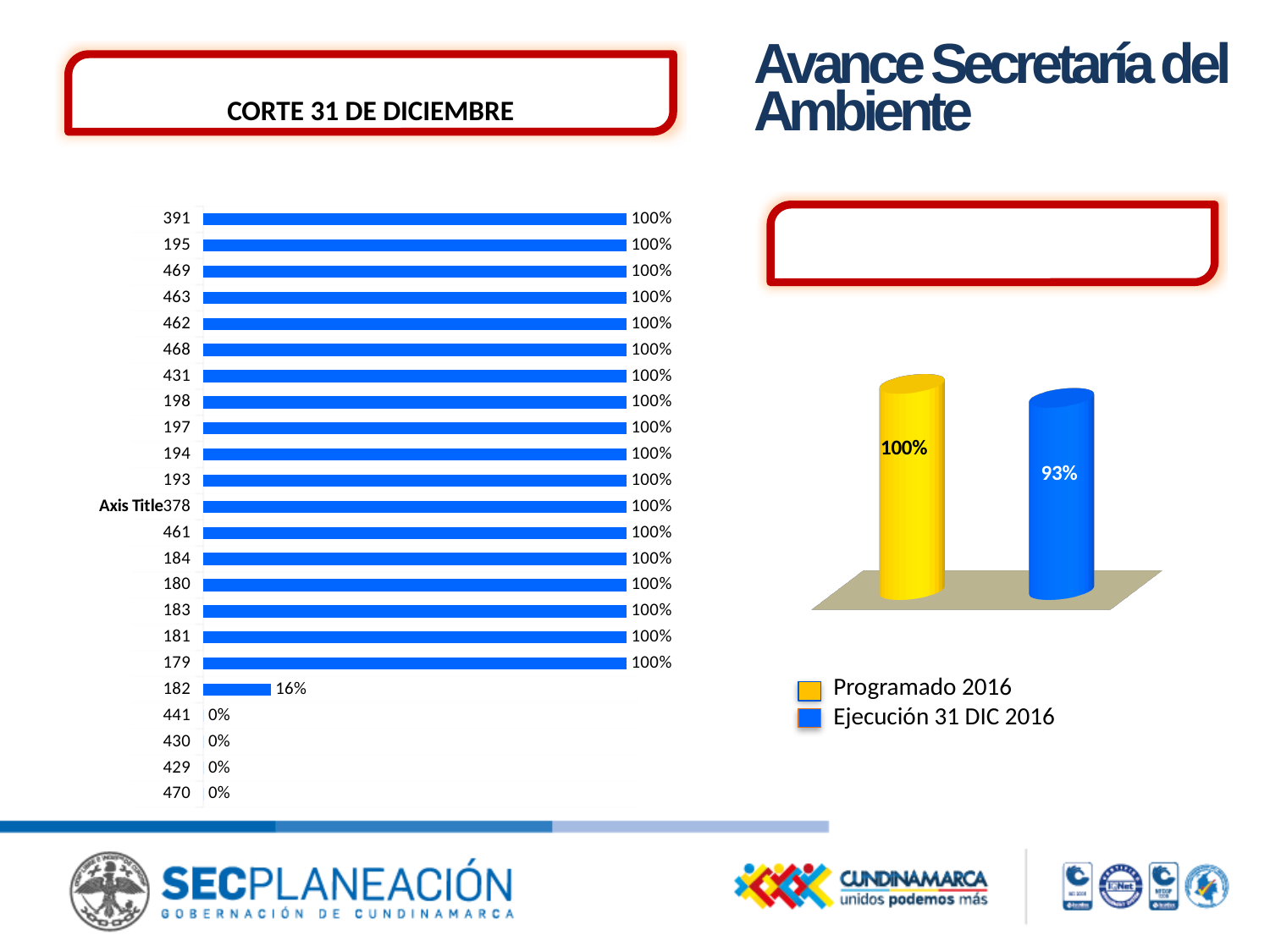
In the left bar chart, what is the difference between the value for 179 and the value for 182? 84% What kind of chart is the chart on the left? Bar chart In the right chart, what is the value for Ejecución 31 DIC 2016? 93% In the left bar chart, which is larger, the value for 182 or the value for 441? 182 In the left bar chart, what is the value for category 470? 0% In the right chart, what colour is the bar for Ejecución 31 DIC 2016? Blue In the right chart, what is the difference between Programado 2016 and Ejecución 31 DIC 2016? 7% In the left bar chart, what is the value for category 391? 100% In the right chart, what is the value for Programado 2016? 100% In the left bar chart, how many categories have a value of 0%? 4 In the left bar chart, how many categories are plotted? 23 In the left bar chart, what is the value for category 182? 16%